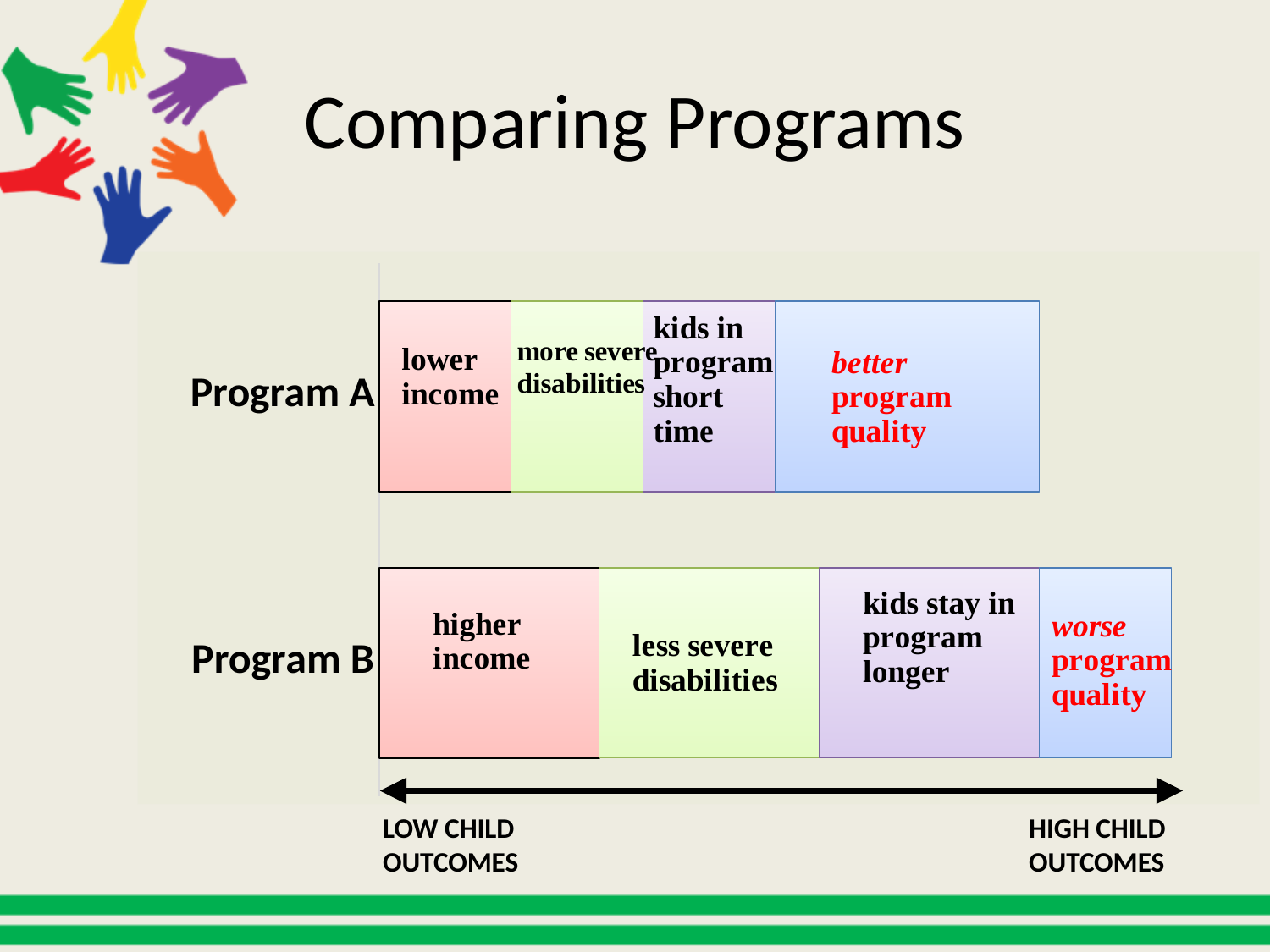
How many programs (bars) are compared in the chart? 2 Is the 'program quality' segment wider for Program A or Program B? Program A What kind of chart is shown on the slide? Stacked horizontal bar chart Which segment is the narrowest in the Program B bar? worse program quality What label appears at the left end of the horizontal axis? LOW CHILD OUTCOMES How many segments make up the bar for Program A? 4 What does the third segment of the Program B bar say? kids stay in program longer Which program's bar extends further toward HIGH CHILD OUTCOMES? Program B Is the 'income' segment wider for Program A or Program B? Program B Which segment is the widest in the Program A bar? better program quality What is the title of the slide containing the chart? Comparing Programs